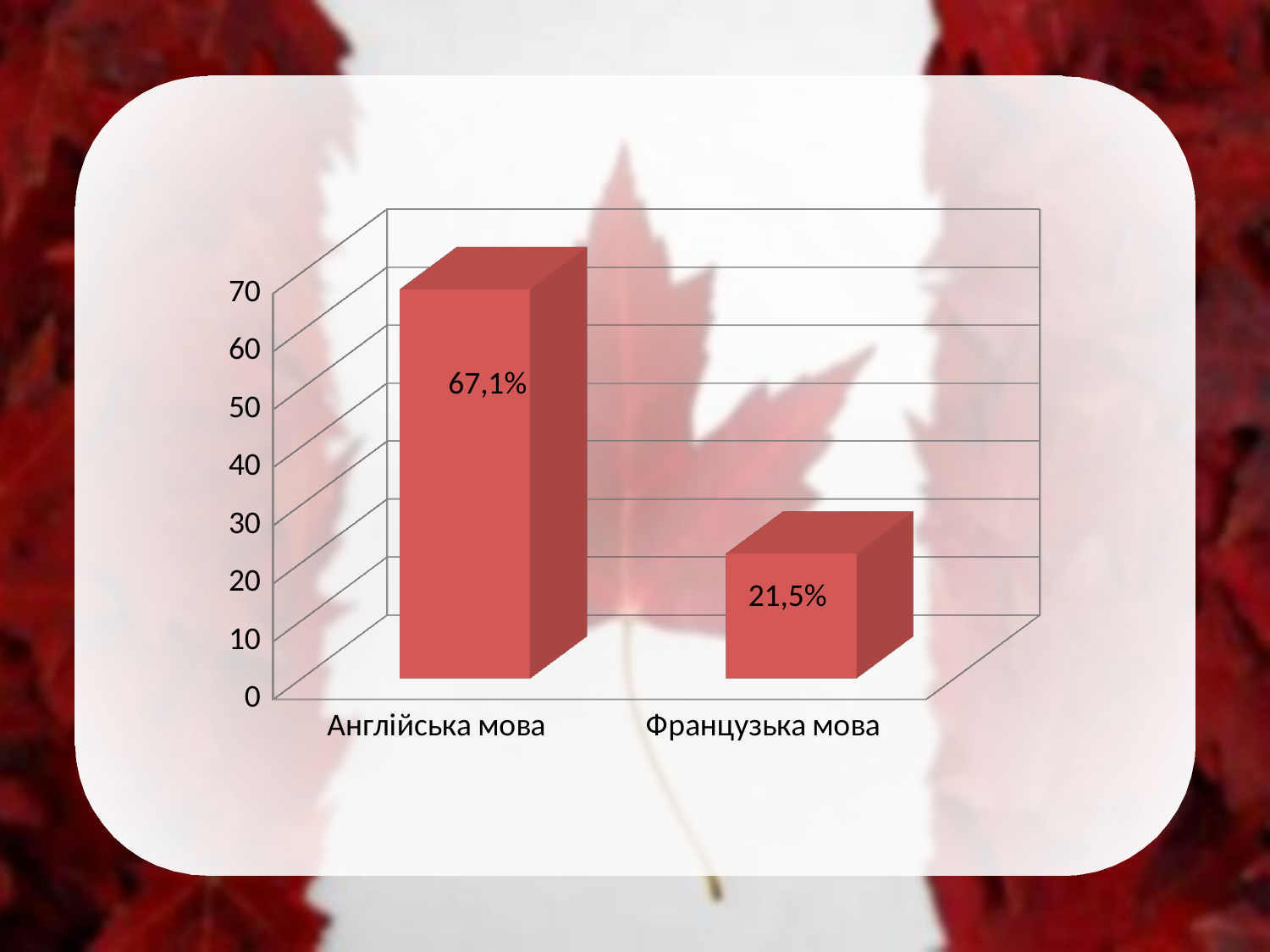
What is the value shown for Французька мова? 21,5% What colour are the bars in the chart? red Which is larger, the value for Англійська мова or the value for Французька мова? Англійська мова Which category has the highest value? Англійська мова What is the difference between the values for Англійська мова and Французька мова? 45,6% Is the value for Французька мова greater or less than 30? less What is the highest value labelled on the vertical axis? 70 What kind of chart is shown on the slide? bar chart What is the value shown for Англійська мова? 67,1% Is the value for Англійська мова greater or less than 60? greater How many categories are shown on the chart? 2 Which category has the lowest value? Французька мова